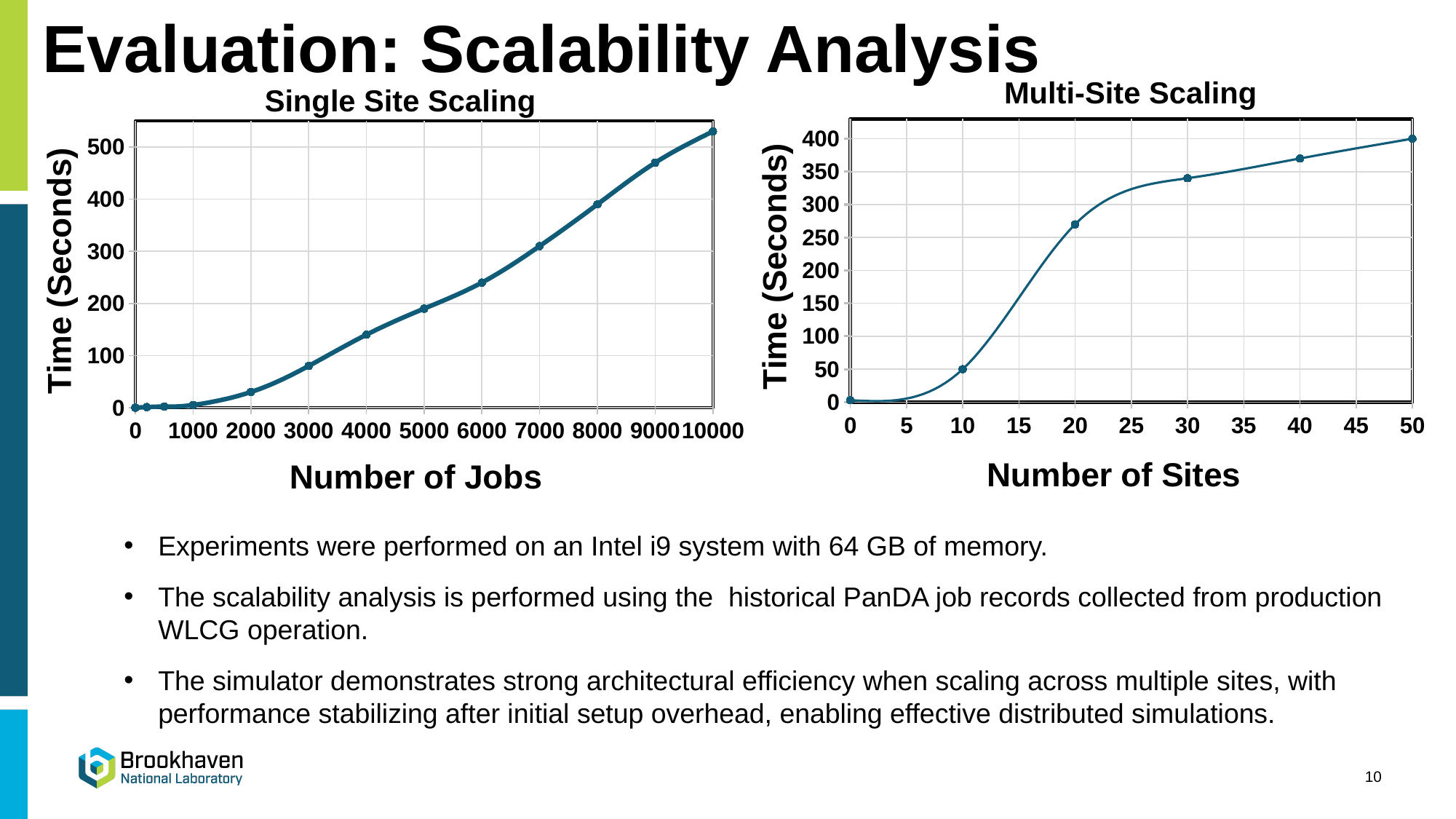
In the Multi-Site Scaling chart, does the time rise or fall as the number of sites increases? rises What is the x-axis title of the Multi-Site Scaling chart? Number of Sites What kind of chart is the Single Site Scaling chart? line chart In the Single Site Scaling chart, at which number of jobs is the time highest? 10000 In the Multi-Site Scaling chart, is the time for 20 sites greater or less than 250 seconds? greater In the Single Site Scaling chart, does the time rise or fall as the number of jobs increases? rises In the Single Site Scaling chart, is the time for 3000 jobs greater or less than 100 seconds? less In the Multi-Site Scaling chart, is the time for 40 sites greater or less than 350 seconds? greater In the Multi-Site Scaling chart, how many data points are plotted? 6 In the Multi-Site Scaling chart, which has the larger time: 10 sites or 20 sites? 20 sites